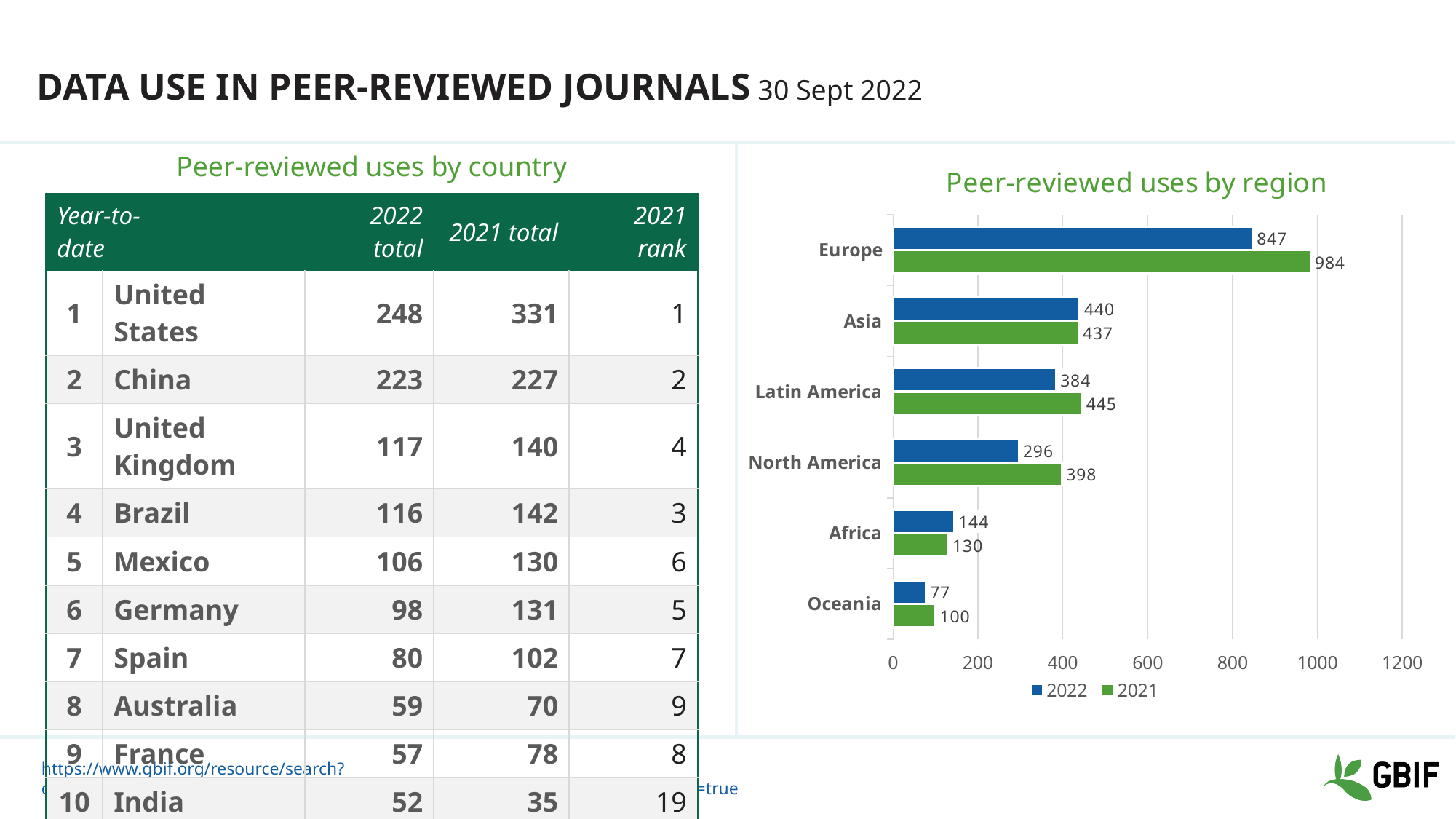
In the 'Peer-reviewed uses by region' chart, which region has the highest 2021 value? Europe In the 'Peer-reviewed uses by region' chart, is the 2022 value for Latin America greater or less than 400? less In the 'Peer-reviewed uses by region' chart, what is the difference between the 2021 and 2022 values for Europe? 137 In the 'Peer-reviewed uses by region' chart, is the 2022 value for Africa larger or smaller than its 2021 value? larger In the 'Peer-reviewed uses by region' chart, what is the 2021 value for Latin America? 445 How many regions are shown in the 'Peer-reviewed uses by region' chart? 6 How many series does the legend of the 'Peer-reviewed uses by region' chart list? 2 In the 'Peer-reviewed uses by region' chart, which region has the lowest 2022 value? Oceania In the 'Peer-reviewed uses by region' chart, what is the 2022 value for Europe? 847 What type of chart is 'Peer-reviewed uses by region'? bar chart In the 'Peer-reviewed uses by region' chart, what is the 2021 value for Oceania? 100 In the 'Peer-reviewed uses by region' chart, what is the difference between the 2021 and 2022 values for North America? 102